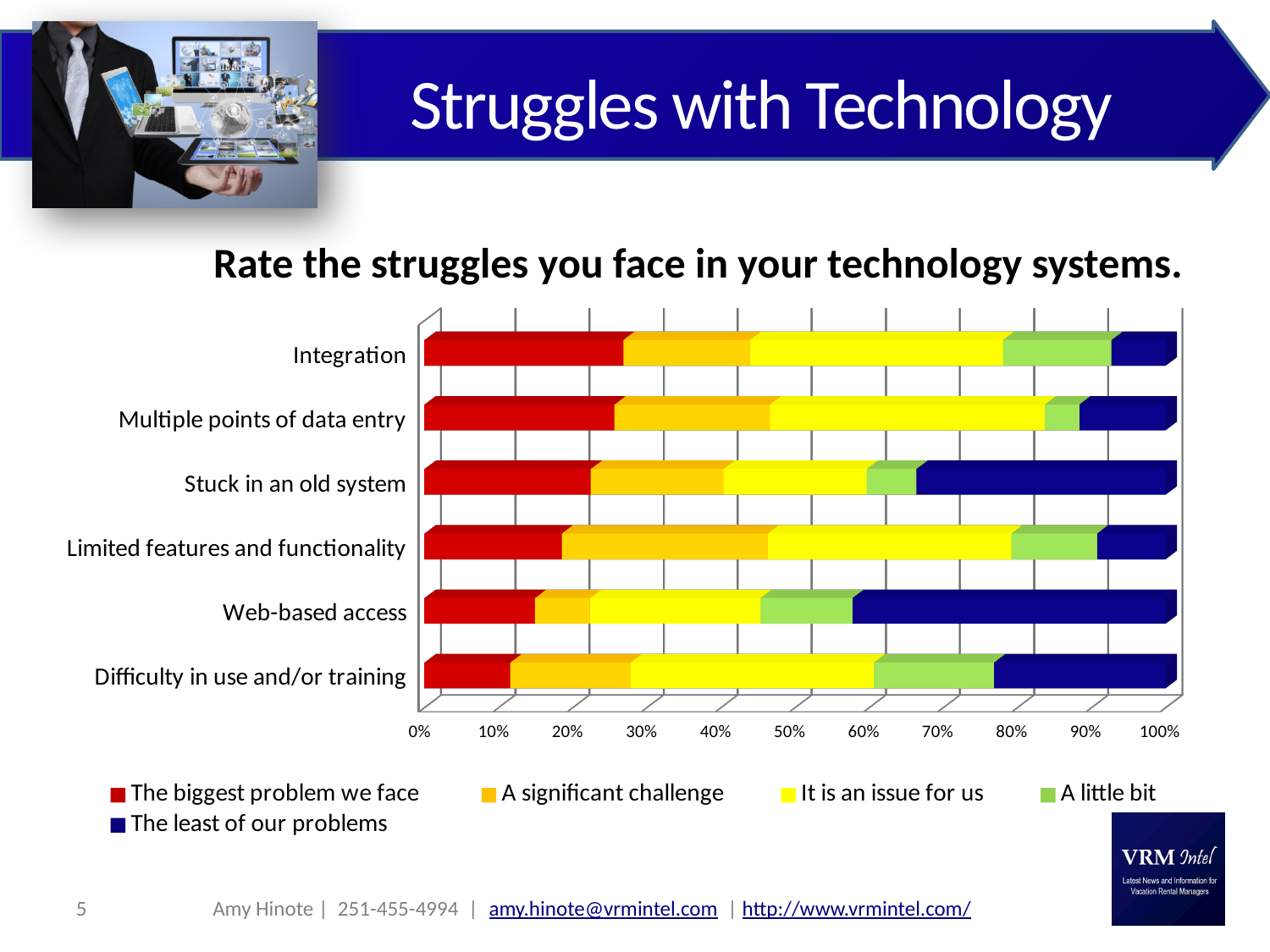
Is the 'The least of our problems' share for Web-based access greater or less than 30%? greater Which legend entry is shown in red? The biggest problem we face Is the 'A little bit' share for Multiple points of data entry greater or less than 10%? less How many categories (struggles) are plotted on the chart? 6 Is the 'The biggest problem we face' share for Integration greater or less than 20%? greater Which has the larger 'It is an issue for us' segment: Difficulty in use and/or training or Stuck in an old system? Difficulty in use and/or training How many series does the legend list? 5 What kind of chart is shown on the slide? Stacked bar chart Which category has the largest 'The least of our problems' segment? Web-based access What is the title of the chart? Rate the struggles you face in your technology systems.